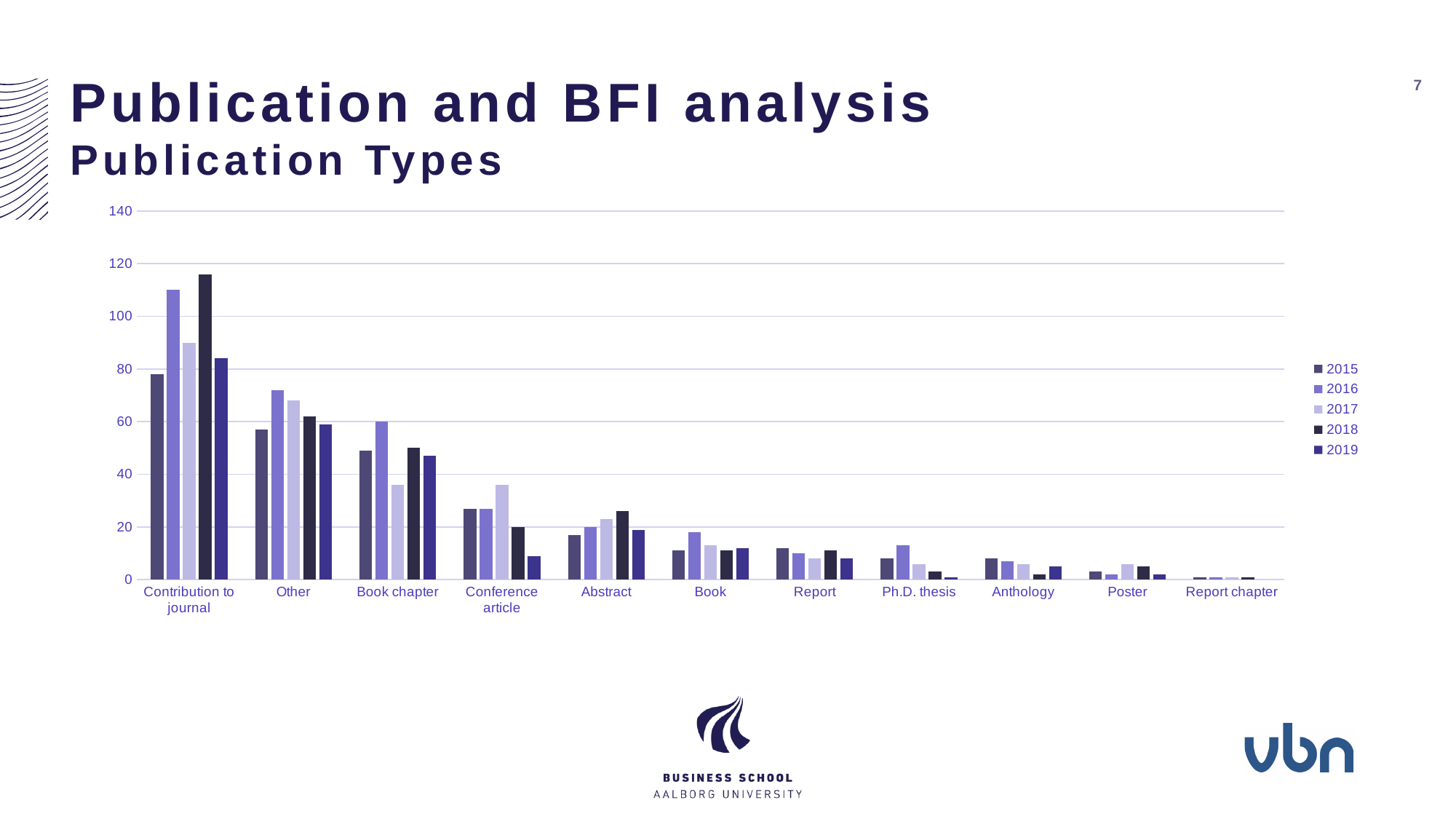
For Conference article, which year has the highest value? 2017 How many publication type categories are shown on the x axis? 11 Which publication type has the tallest bar in the chart? Contribution to journal For Contribution to journal, which year has the highest value? 2018 Which years are listed in the legend? 2015, 2016, 2017, 2018, 2019 Is the value for Conference article in 2019 greater or less than 20? less How many series does the legend list? 5 What kind of chart is shown on the slide? bar chart Is the value for Contribution to journal in 2018 greater or less than 100? greater Which publication type has the lowest bars overall? Report chapter For Book chapter, which is larger: the 2016 value or the 2017 value? 2016